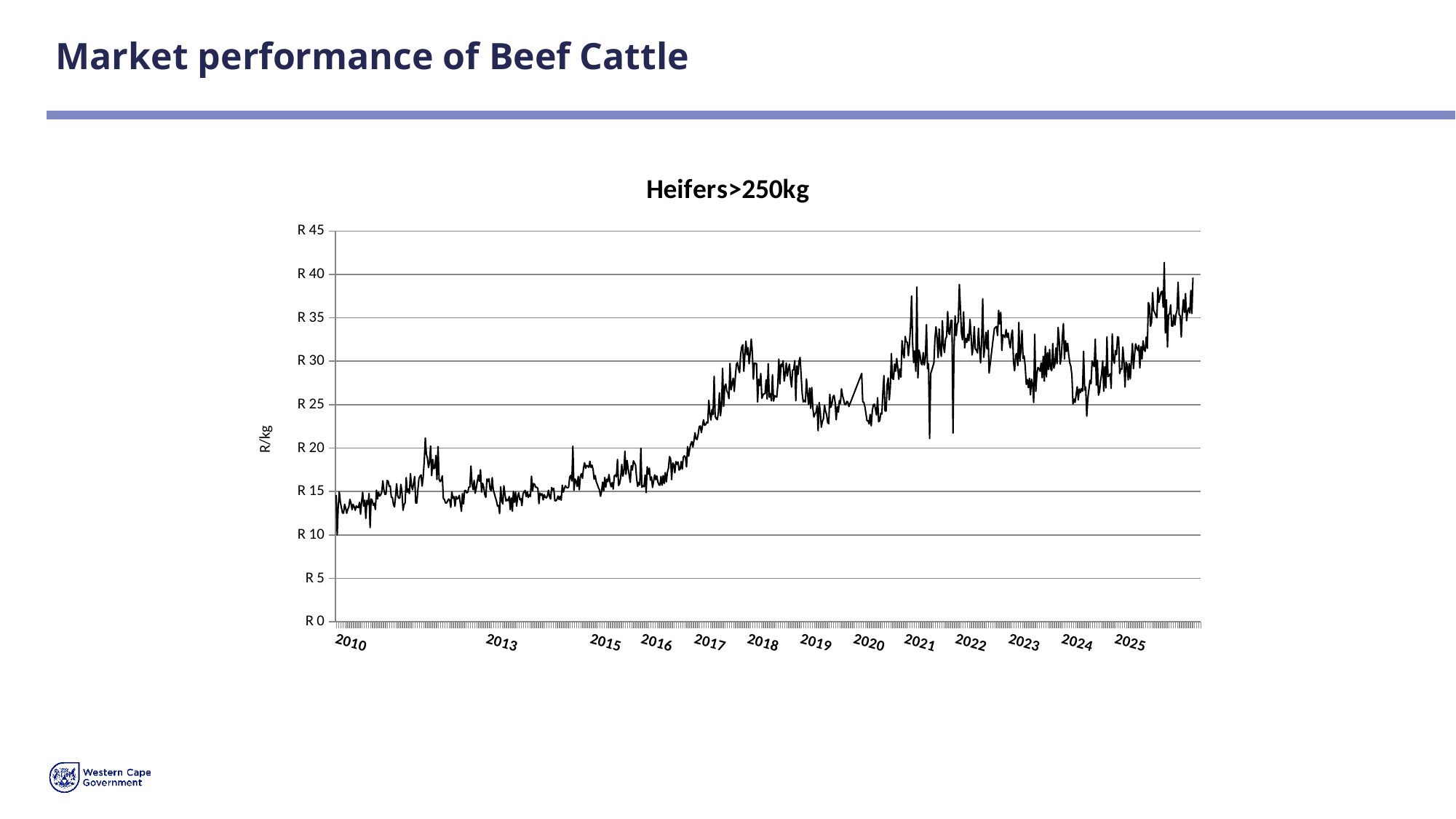
What is the title of the chart? Heifers>250kg Is the value for 2010 greater or less than R 20? less Is the value for 2022 greater or less than R 25? greater Overall, do the values rise or fall from 2010 to 2025? rise Is the value for 2017 greater or less than R 15? greater What is the label on the vertical axis of the chart? R/kg What kind of chart is shown on the slide? line chart Which is larger, the value in 2013 or the value in 2023? 2023 Which is larger, the value in 2016 or the value in 2021? 2021